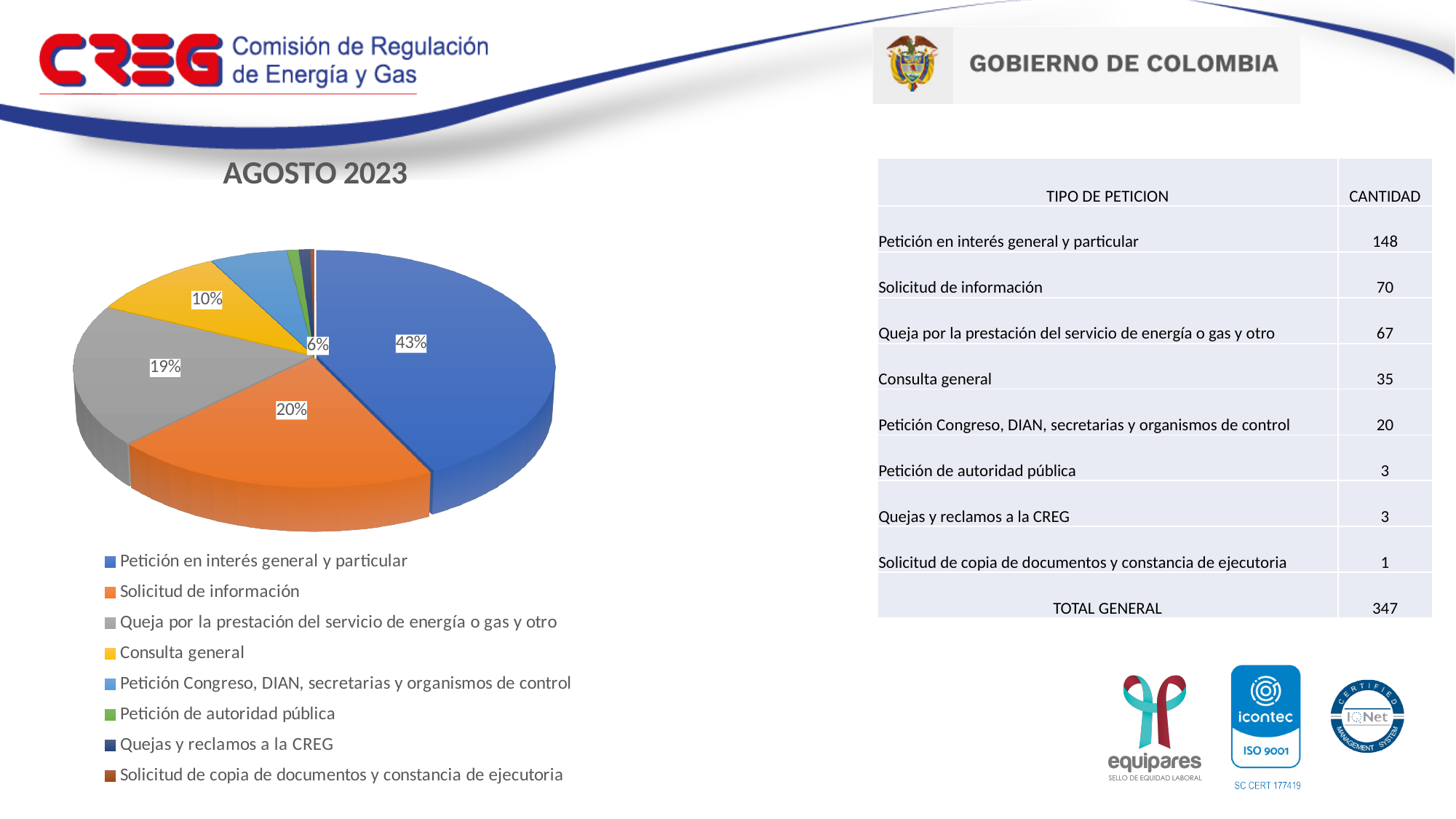
What percentage is shown for 'Consulta general' in the pie chart? 10% Which is larger in the pie chart: the slice for 'Consulta general' or the slice for 'Petición Congreso, DIAN, secretarias y organismos de control'? Consulta general What colour is the slice for 'Solicitud de información' in the pie chart? orange What kind of chart is shown on the slide? pie chart What share of the pie does 'Petición en interés general y particular' represent? 43% What percentage is shown for 'Queja por la prestación del servicio de energía o gas y otro' in the pie chart? 19% What percentage is shown for 'Petición Congreso, DIAN, secretarias y organismos de control' in the pie chart? 6% Which category has the largest slice in the pie chart? Petición en interés general y particular What is the title of the pie chart? AGOSTO 2023 What percentage is shown for 'Solicitud de información' in the pie chart? 20% How many categories does the pie chart's legend list? 8 By how many percentage points does the 'Petición en interés general y particular' slice exceed the 'Solicitud de información' slice? 23